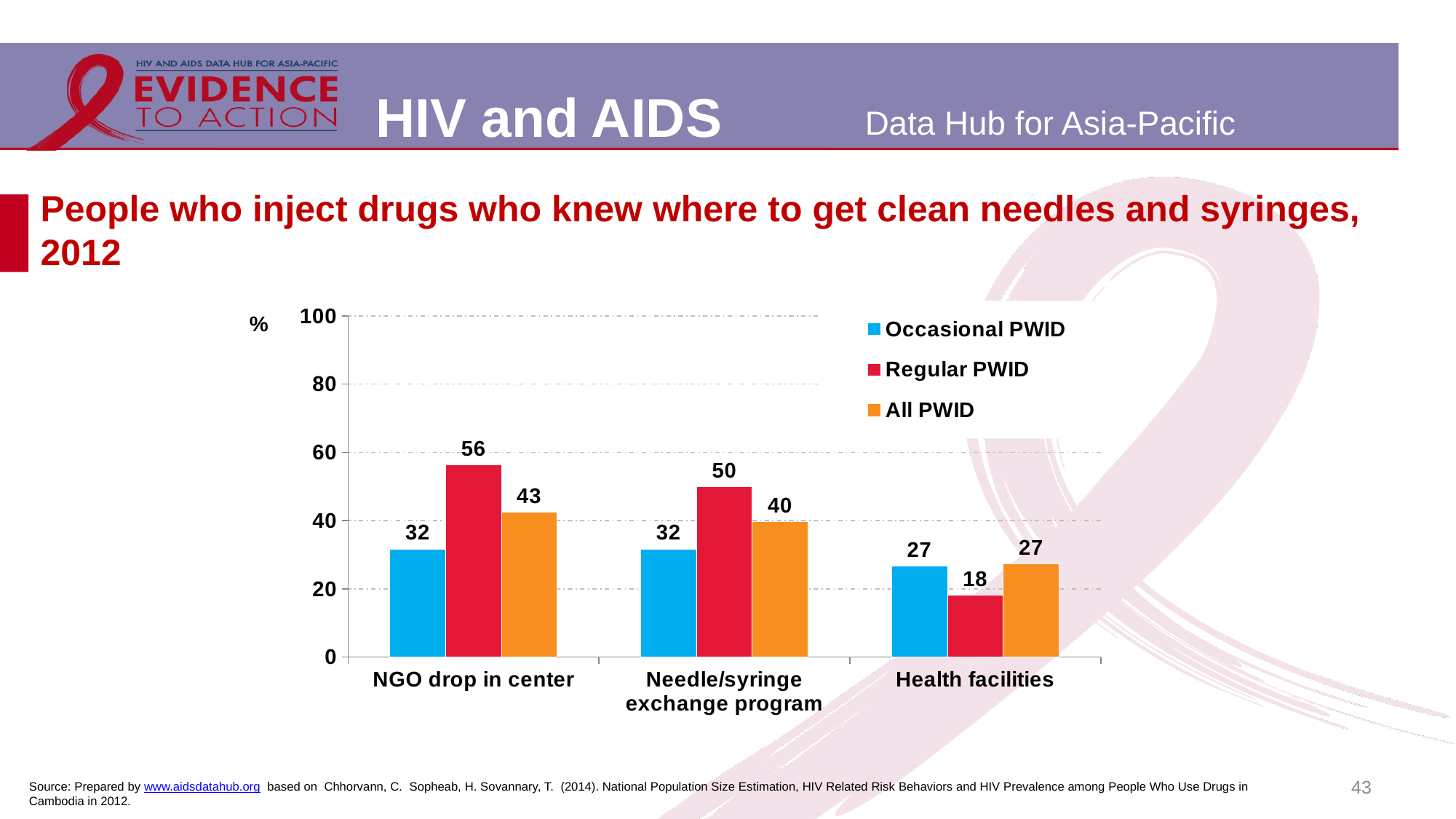
What colour represents All PWID in the chart? Orange What is the value for Regular PWID at Health facilities? 18 What is the value for Occasional PWID at Health facilities? 27 Which is larger at Health facilities: Occasional PWID or Regular PWID? Occasional PWID How many series does the legend list? 3 What is the value for All PWID at Needle/syringe exchange program? 40 Which category has the highest value for Regular PWID? NGO drop in center What is the difference between Regular PWID and Occasional PWID at NGO drop in center? 24 Which category has the lowest value for All PWID? Health facilities What is the value for Regular PWID at NGO drop in center? 56 How many categories are shown on the x axis? 3 What kind of chart is shown on the slide? Bar chart